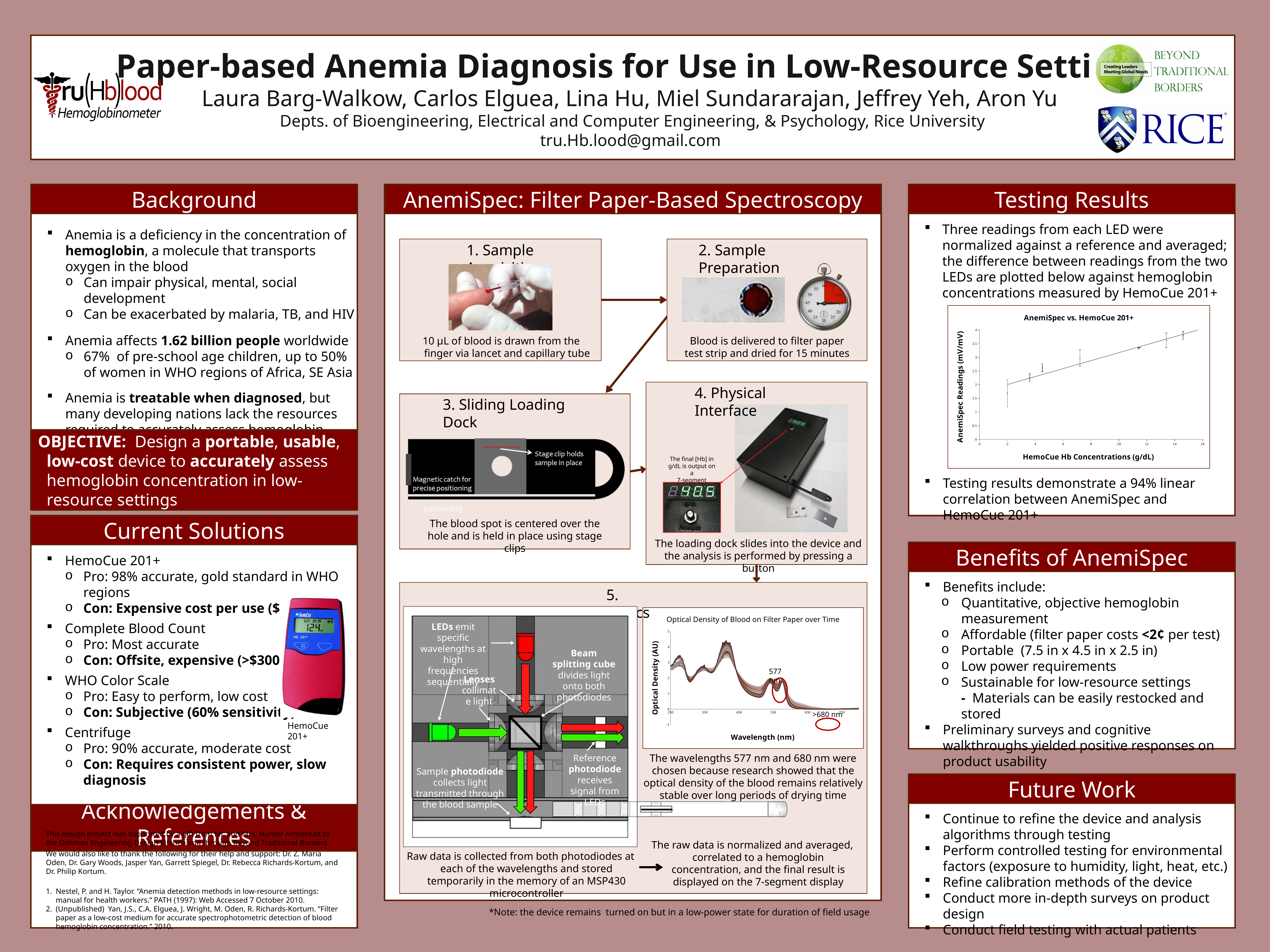
In the 'Optical Density of Blood on Filter Paper over Time' chart, is the optical density at 750 nm greater or less than 1? less In the 'Optical Density of Blood on Filter Paper over Time' chart, is the optical density at 450 nm greater or less than 2? greater In the 'AnemiSpec vs. HemoCue 201+' chart, do the AnemiSpec readings rise or fall as HemoCue Hb concentration increases? rise In the 'Optical Density of Blood on Filter Paper over Time' chart, which wavelength is annotated next to the circled peak near 550 nm? 577 In the 'AnemiSpec vs. HemoCue 201+' chart, which has the larger AnemiSpec reading: the point at about 2 g/dL or the point at about 14 g/dL? the point at about 14 g/dL What is the title of the chart in the Testing Results section? AnemiSpec vs. HemoCue 201+ What kind of chart is 'Optical Density of Blood on Filter Paper over Time'? line chart In the 'AnemiSpec vs. HemoCue 201+' chart, what is the highest value shown on the x axis? 16 In the 'AnemiSpec vs. HemoCue 201+' chart, what kind of chart is shown? scatter chart In the 'AnemiSpec vs. HemoCue 201+' chart, is the AnemiSpec reading at a HemoCue concentration of 2 g/dL greater or less than 3? less In the 'Optical Density of Blood on Filter Paper over Time' chart, what is the y-axis label? Optical Density (AU)